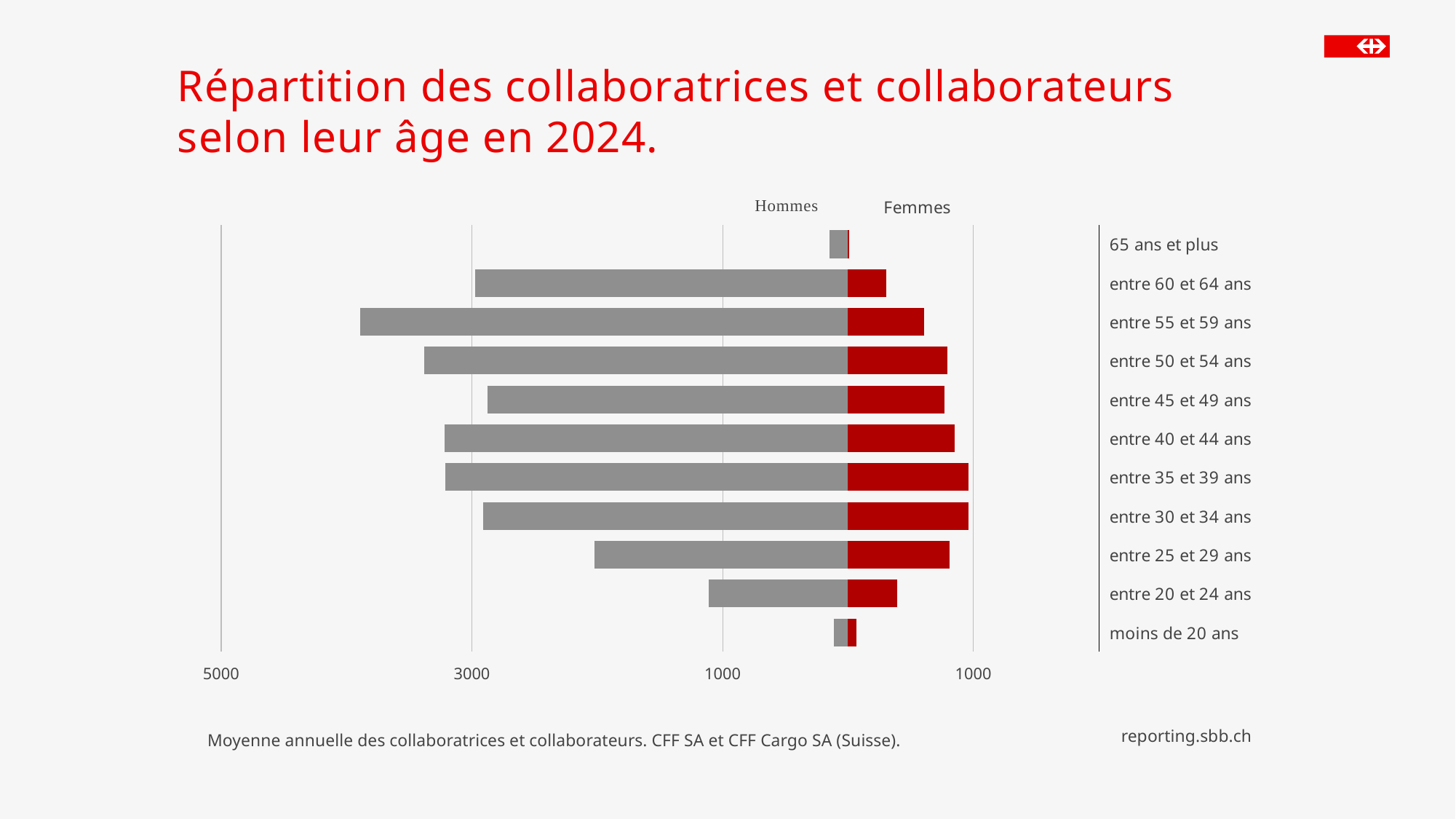
Which age group has the highest value for Hommes? entre 55 et 59 ans What colour are the Femmes bars in the chart? red Is the Hommes value for 'entre 25 et 29 ans' greater or less than 3000? less Which is larger for Femmes: 'entre 55 et 59 ans' or 'entre 20 et 24 ans'? entre 55 et 59 ans Is the Hommes value for 'entre 25 et 29 ans' greater or less than 1000? greater What kind of chart is shown on the slide? bar chart Which is larger for Hommes: 'entre 55 et 59 ans' or 'entre 50 et 54 ans'? entre 55 et 59 ans How many series does the chart show? 2 Is the Femmes value for 'entre 20 et 24 ans' greater or less than 1000? less For the age group 'entre 40 et 44 ans', which is larger: Hommes or Femmes? Hommes How many age groups are shown in the chart? 11